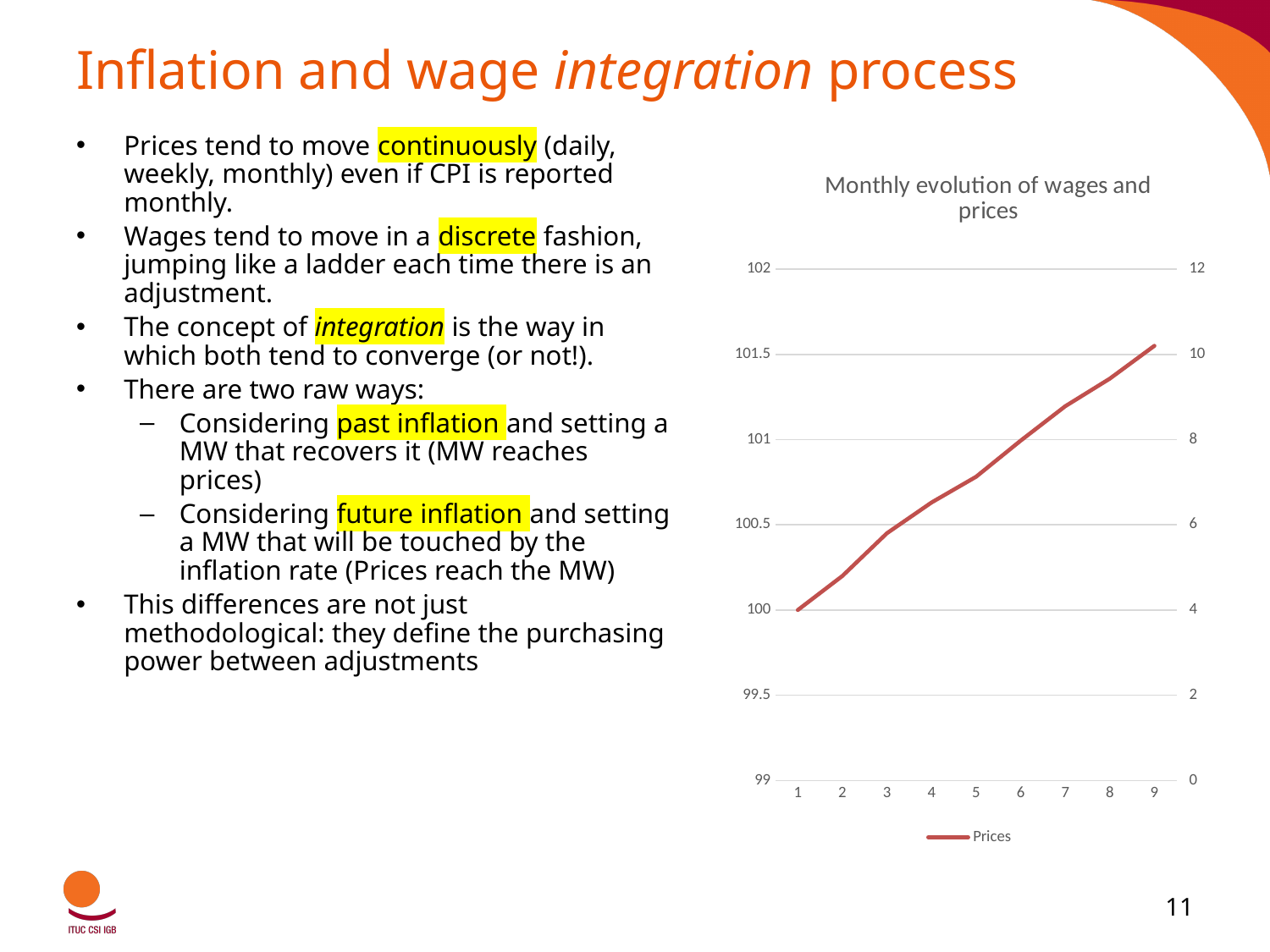
At which month is the Prices value lowest? 1 What series name appears in the chart legend? Prices Is the Prices value at month 2 greater or less than 100.5? less What kind of chart is shown on the slide? line chart Which is larger, the Prices value at month 3 or at month 7? month 7 Do the Prices values rise or fall from month 1 to month 9? rise How many points are plotted along the x axis of the chart? 9 What is the title of the chart? Monthly evolution of wages and prices How many series does the chart legend list? 1 Is the Prices value at month 9 greater or less than 101? greater At which month is the Prices value highest? 9 Is the Prices value at month 5 greater or less than 100.5? greater